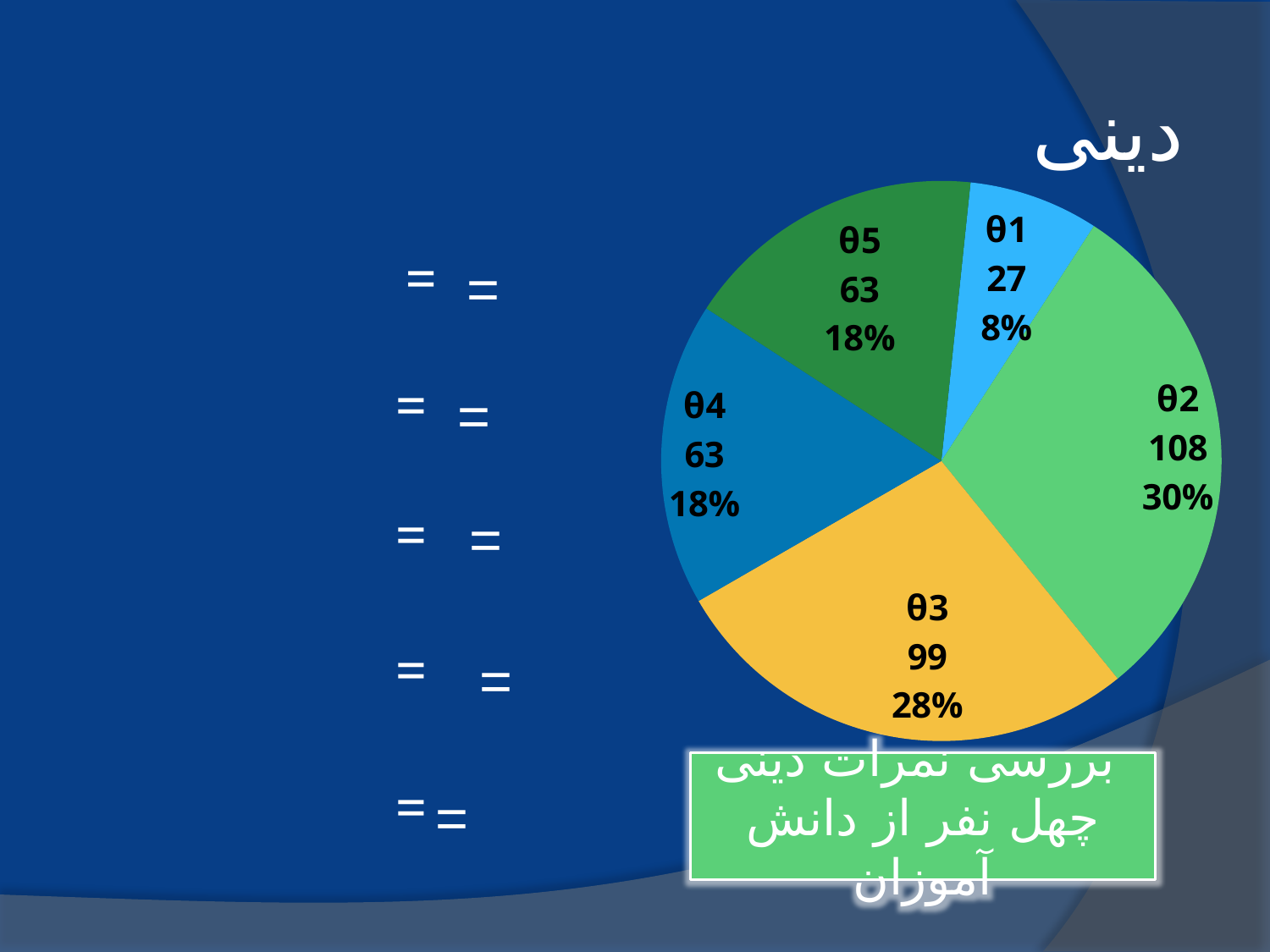
How many slices does the pie chart have? 5 Which slice of the pie chart is the smallest? θ1 What is the title shown above the pie chart? دینی What value is printed on the θ2 slice of the pie chart? 108 What is the difference between the values of θ2 and θ1? 81 What type of chart is shown on the slide? pie chart What percentage is shown for the θ3 slice? 28% Which is larger, the value for θ3 or the value for θ5? θ3 What value is printed on the θ4 slice? 63 What is the difference between the values of θ2 and θ3? 9 What percentage is shown for the θ1 slice? 8% Which slice of the pie chart is the largest? θ2